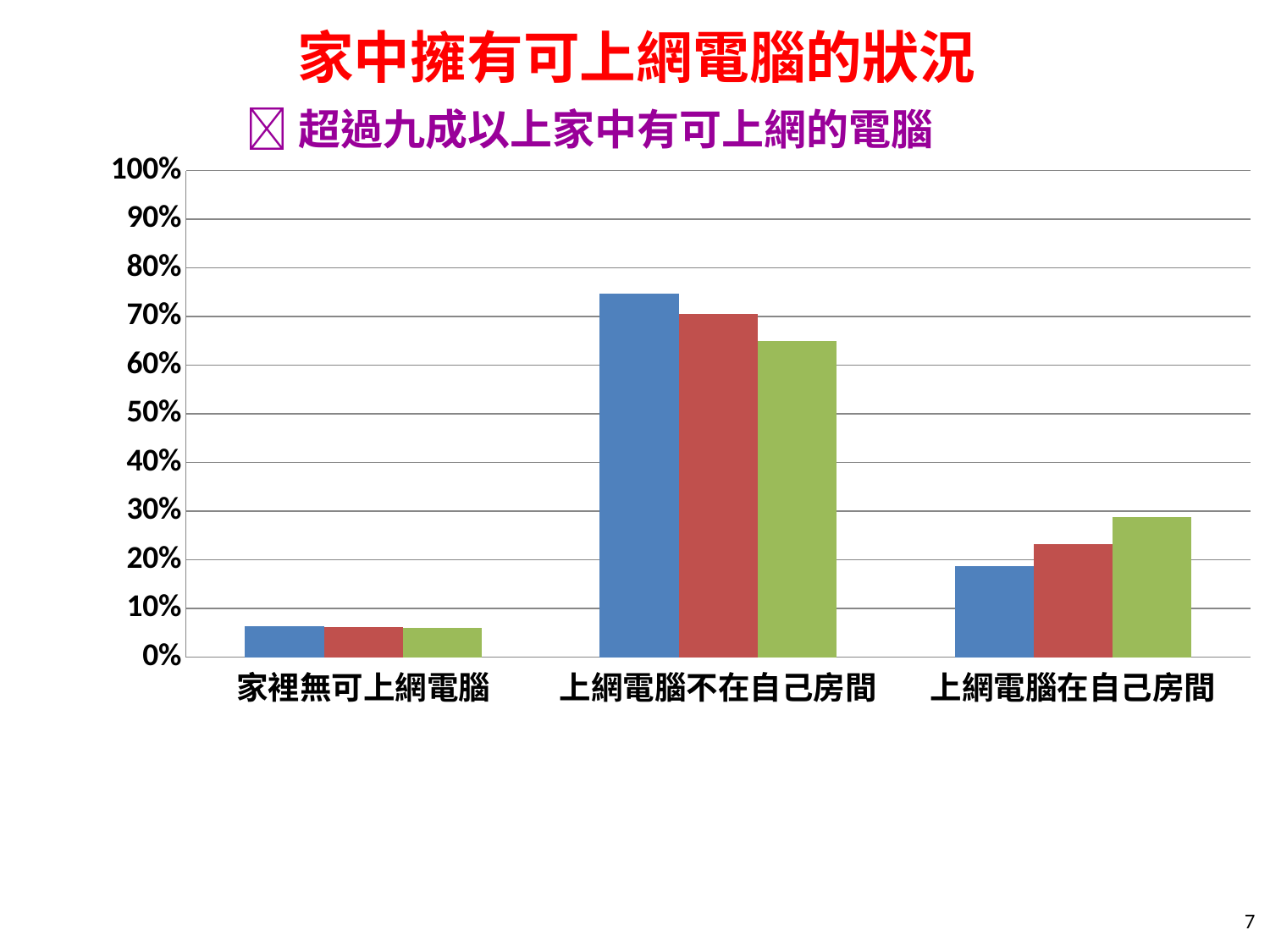
Is the value of the green bar for 家裡無可上網電腦 greater or less than 10%? less Which category has the tallest bars in the chart? 上網電腦不在自己房間 Which category has the shortest bars in the chart? 家裡無可上網電腦 How many categories are shown along the x axis of the chart? 3 For 上網電腦在自己房間, which bar is taller, the blue bar or the green bar? the green bar Is the value of the green bar for 上網電腦不在自己房間 greater or less than 70%? less Is the value of the blue bar for 上網電腦不在自己房間 greater or less than 70%? greater For 上網電腦不在自己房間, which bar is taller, the blue bar or the green bar? the blue bar What is the title of the chart on the slide? 家中擁有可上網電腦的狀況 What kind of chart is shown on the slide? bar chart How many bars are plotted for each category in the chart? 3